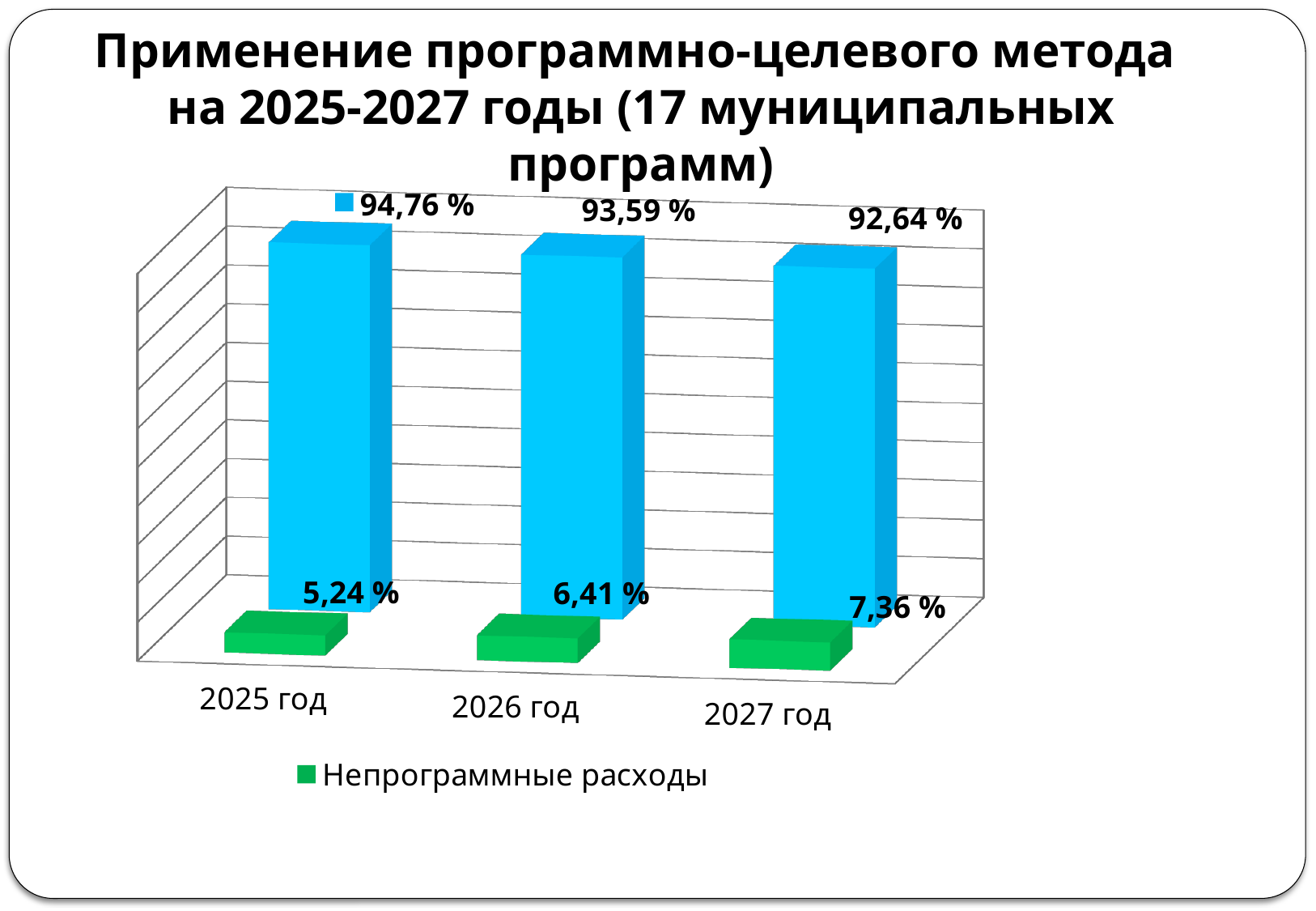
In which year is the blue bar the lowest? 2027 год What is the value of Непрограммные расходы for 2027 год? 7,36 % What value is shown on the tall blue bar for 2027 год? 92,64 % What is the value of Непрограммные расходы for 2026 год? 6,41 % What is the value of Непрограммные расходы for 2025 год? 5,24 % What is the difference between Непрограммные расходы in 2027 год and in 2025 год? 2,12 % What value is shown on the tall blue bar for 2025 год? 94,76 % In which year is the value of Непрограммные расходы the highest? 2027 год What kind of chart is shown on the slide? bar chart How many years are shown on the x axis of the chart? 3 Do the values of Непрограммные расходы rise or fall from 2025 год to 2027 год? rise Which year has the larger blue bar value, 2025 год or 2026 год? 2025 год